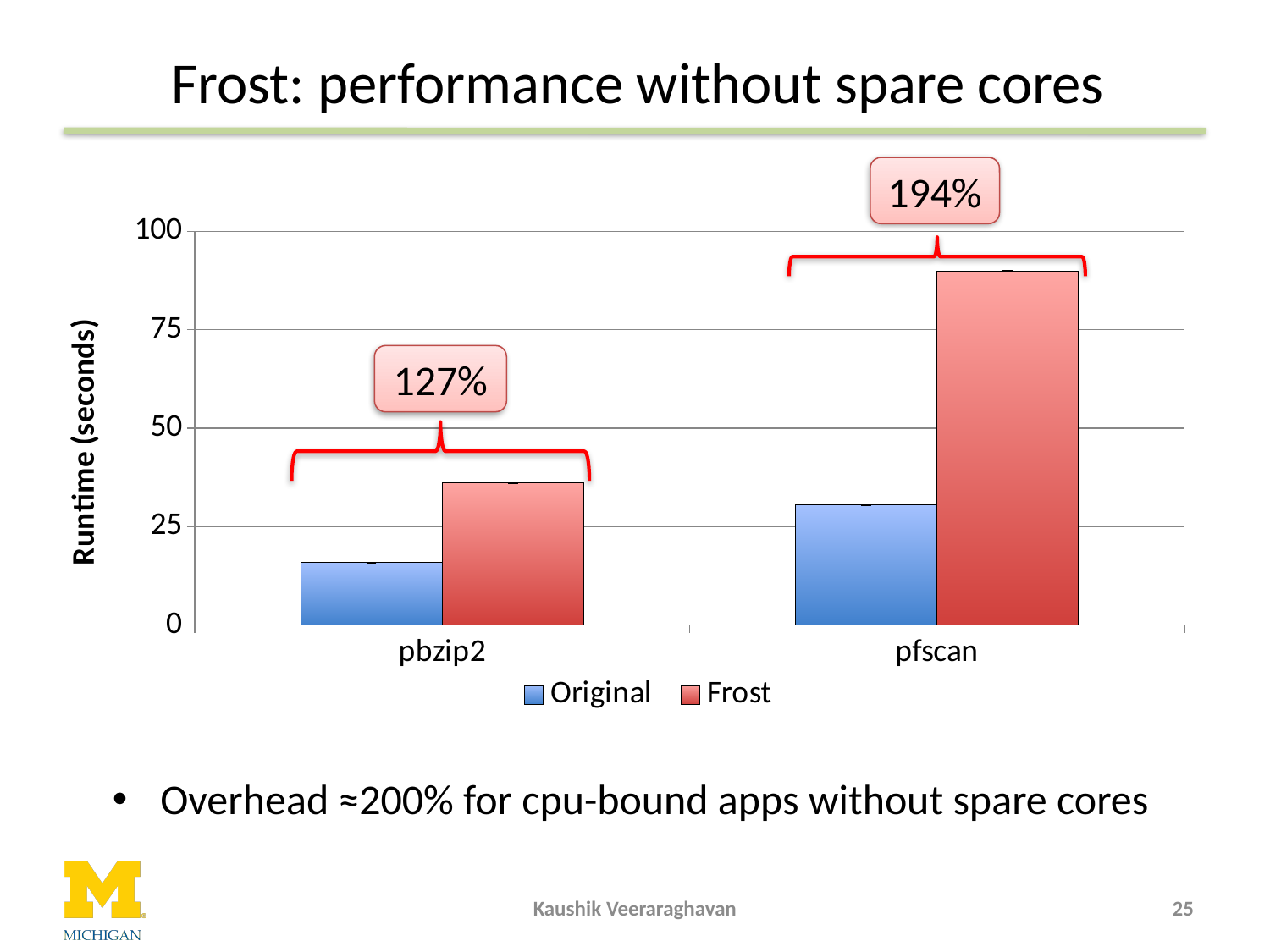
How many series does the chart's legend list? 2 Is the Frost runtime for pbzip2 greater or less than 50? less Which category has the highest Frost runtime? pfscan Is the Frost runtime for pfscan greater or less than 75? greater What is the label of the chart's y axis? Runtime (seconds) Which category has the lowest Original runtime? pbzip2 Is the Original runtime for pbzip2 greater or less than 25? less How many categories are shown on the x axis of the chart? 2 What kind of chart is shown on the slide? bar chart Which series are listed in the chart's legend? Original and Frost For pbzip2, which series has the larger runtime, Original or Frost? Frost